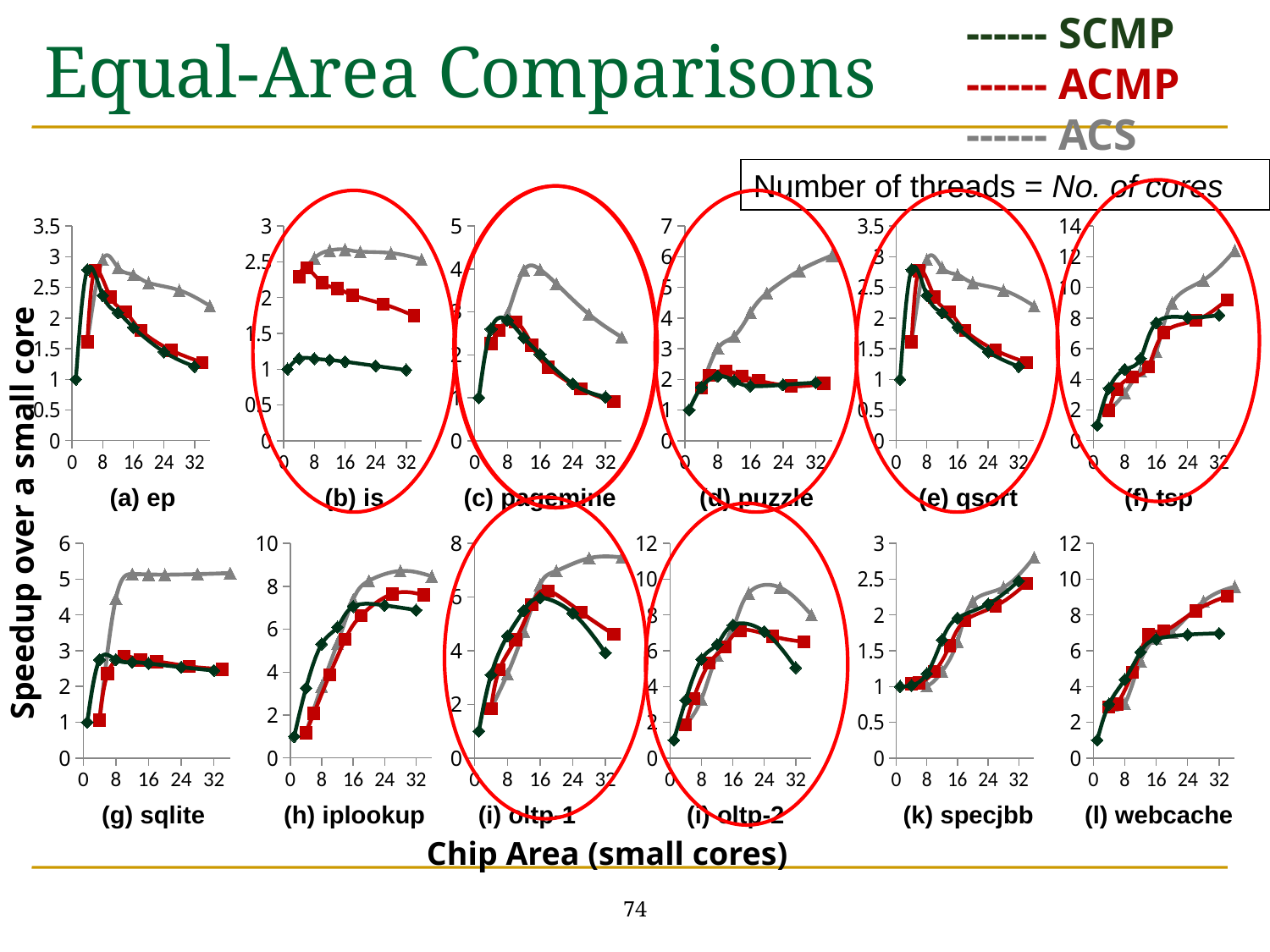
In panel (b) is, is the ACS value at chip area 32 greater or less than 2? greater What is the title of the slide? Equal-Area Comparisons How many series does the legend at the top right list? 3 In panel (g) sqlite, is the ACS value at chip area 32 greater or less than 4? greater How many small chart panels are shown on the slide? 12 In panel (f) tsp, at chip area 32, which series is higher, ACS or ACMP? ACS In panel (k) specjbb, does the SCMP line rise or fall as chip area increases? rise What is the label of the shared y axis of the charts? Speedup over a small core In panel (b) is, at chip area 32, which series is higher, SCMP or ACMP? ACMP What kind of chart is used in panel (a) ep? line chart In panel (d) puzzle, is the ACS value at chip area 32 greater or less than 5? greater